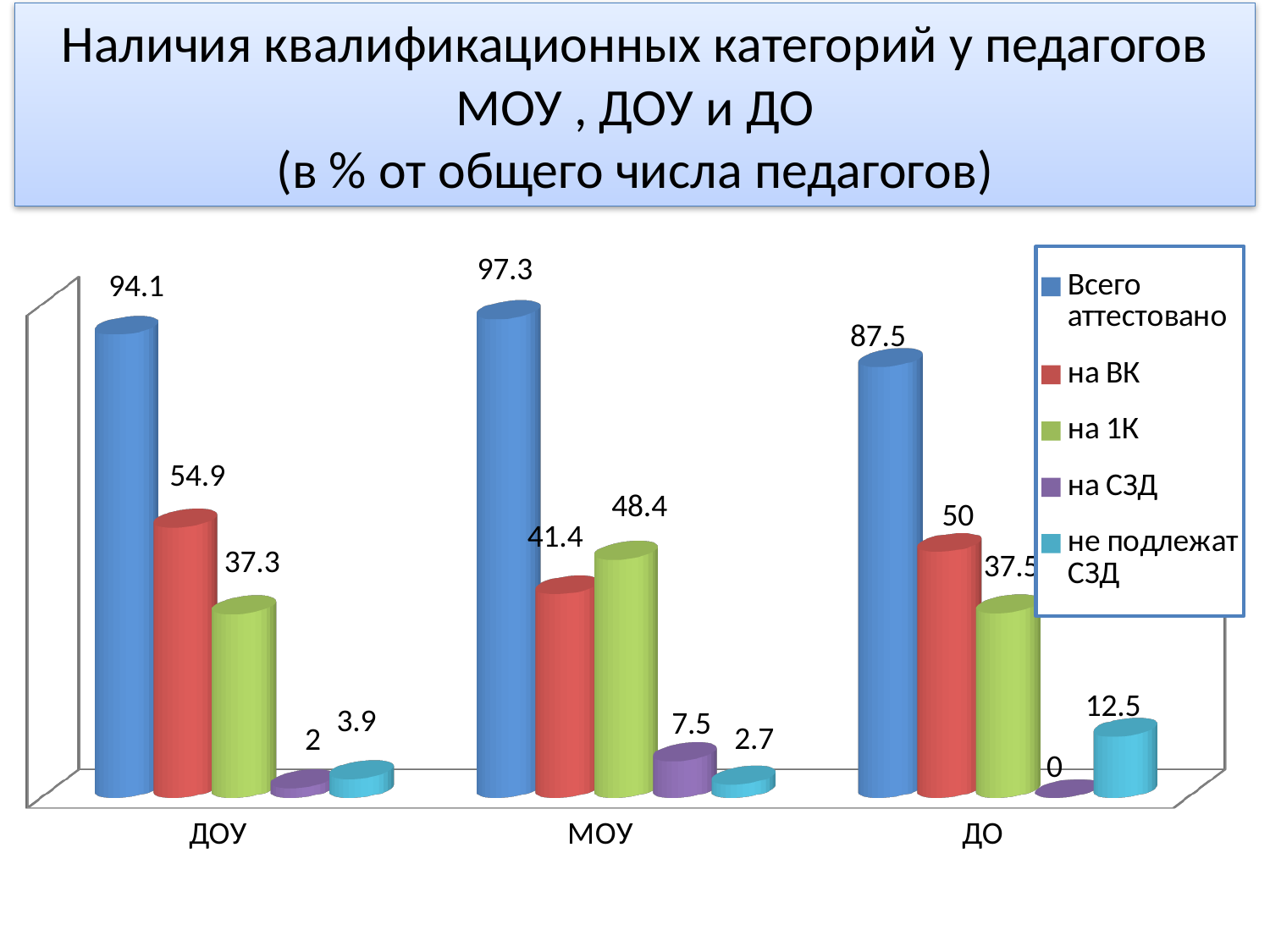
Which category has the lowest value for 'на СЗД'? ДО How many series does the legend list? 5 How many categories are shown on the x axis? 3 What is the value for 'на СЗД' in the ДО category? 0 Which category has the highest value for 'Всего аттестовано'? МОУ Which is larger: 'на 1К' in МОУ or 'на 1К' in ДОУ? на 1К in МОУ What is the value for 'Всего аттестовано' in the ДОУ category? 94.1 What is the value for 'на ВК' in the МОУ category? 41.4 What is the difference between 'на ВК' in ДОУ and 'на ВК' in ДО? 4.9 Which series is shown in red in the legend? на ВК What kind of chart is shown on the slide? Bar chart What is the value for 'не подлежат СЗД' in the ДО category? 12.5